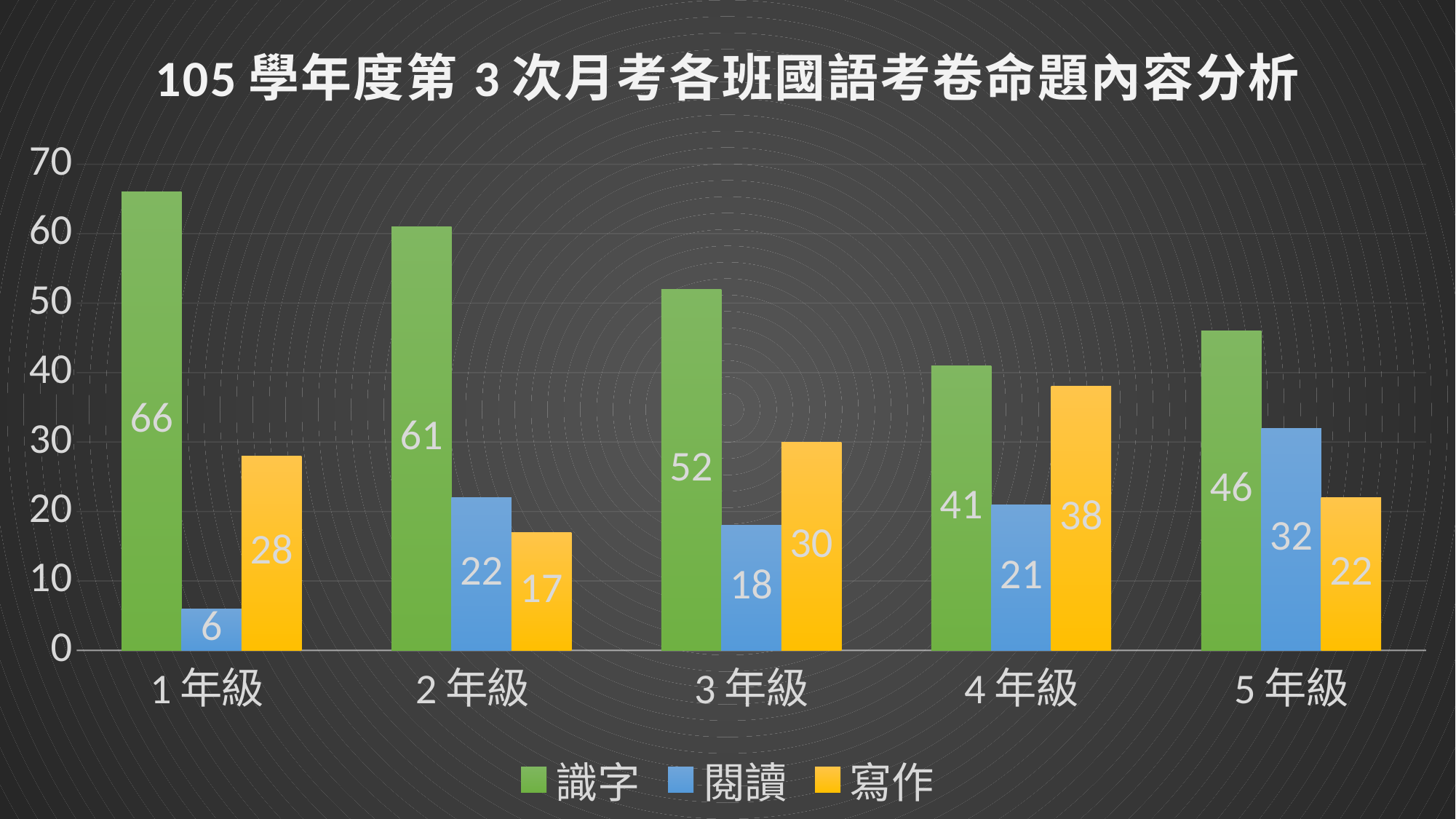
Which grade has the highest 識字 value? 1 年級 Which is larger in 2 年級, 閱讀 or 寫作? 閱讀 How many series does the legend list? 3 What kind of chart is shown on the slide? bar chart What is the value for 識字 in 1 年級? 66 What is the difference between the 識字 and 寫作 values in 3 年級? 22 Which grade has the lowest 閱讀 value? 1 年級 Is the value for 識字 in 5 年級 greater or less than 50? less Do the 識字 values rise or fall from 1 年級 to 5 年級? fall How many grade categories are shown on the x axis? 5 What is the value for 寫作 in 4 年級? 38 What is the value for 閱讀 in 5 年級? 32